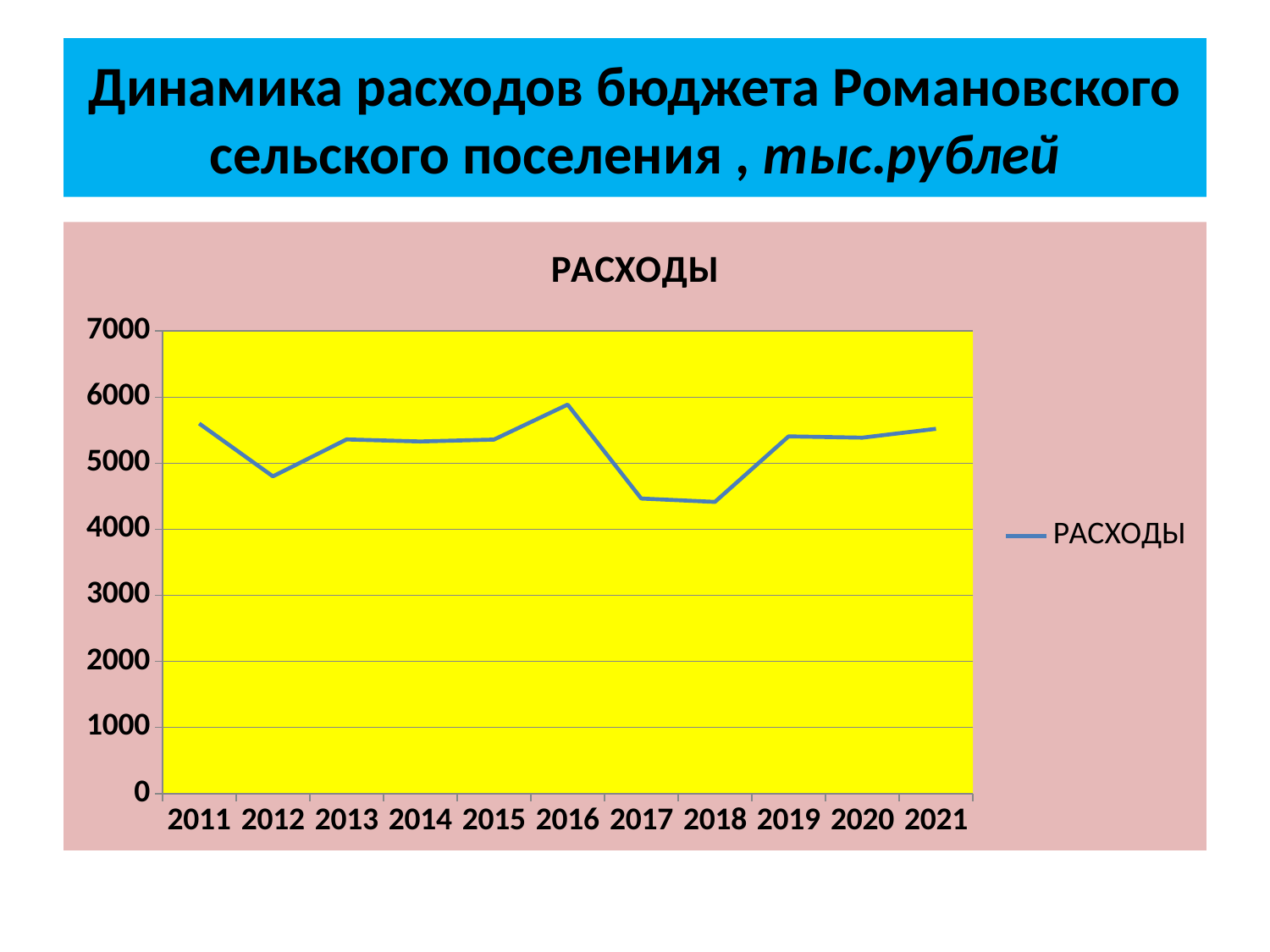
Is the value for 2021 greater or less than 5000? greater How many series does the legend of the chart list? 1 Which year has the larger value, 2016 or 2017? 2016 How many years are plotted along the x axis of the chart? 11 Is the value for 2012 greater or less than 5000? less Is the value for 2016 greater or less than 5000? greater In which year is the value of РАСХОДЫ highest? 2016 What kind of chart is shown on the slide? line chart Does the value rise or fall from 2018 to 2019? rise What is the title of the chart? РАСХОДЫ Which year has the larger value, 2011 or 2012? 2011